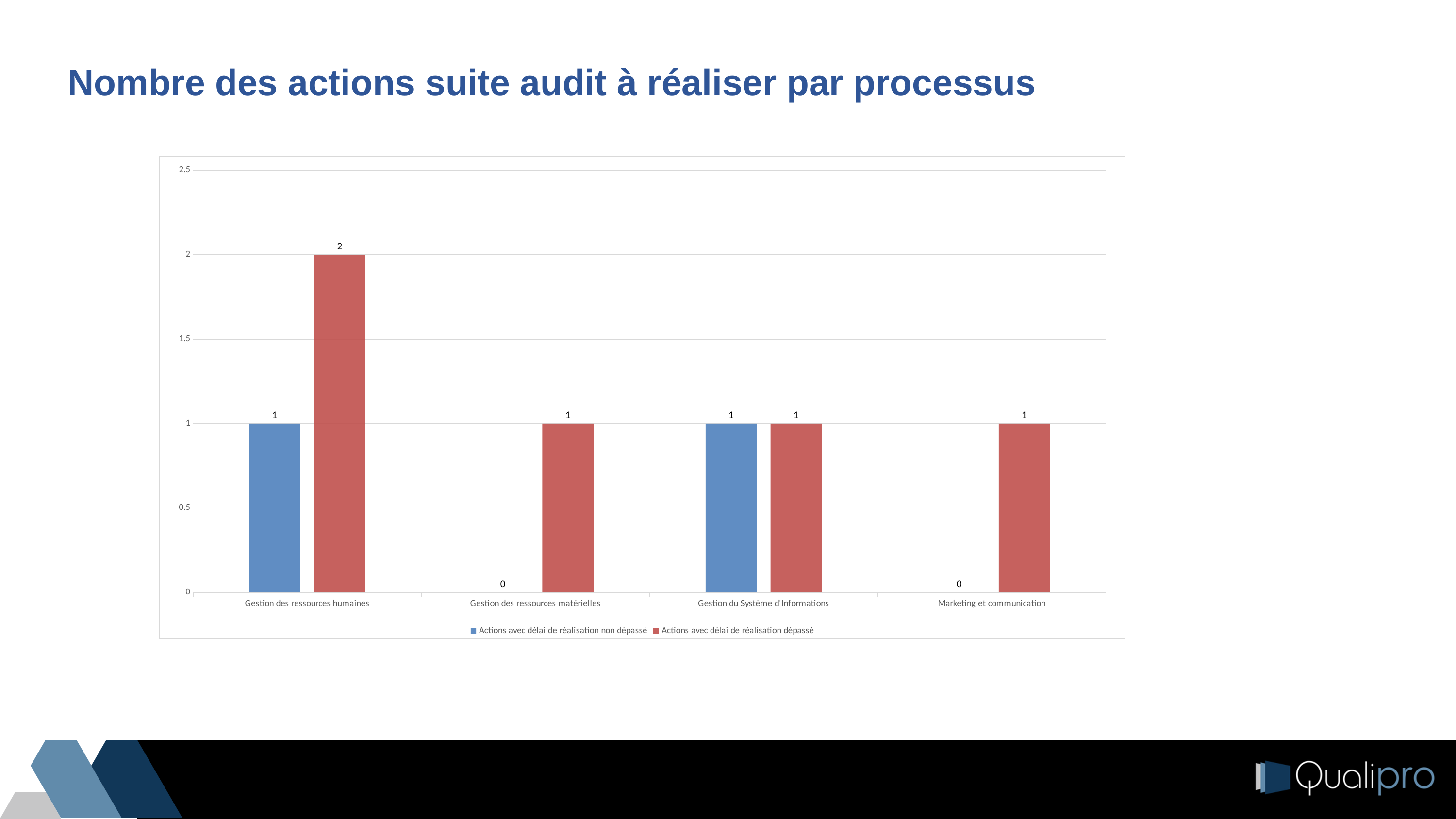
What is the value of 'Actions avec délai de réalisation non dépassé' for Gestion du Système d'Informations? 1 How many processes are shown on the x axis? 4 For Gestion des ressources matérielles, which is larger: 'Actions avec délai de réalisation non dépassé' or 'Actions avec délai de réalisation dépassé'? Actions avec délai de réalisation dépassé Which process has the highest value for 'Actions avec délai de réalisation dépassé'? Gestion des ressources humaines What is the title of the slide? Nombre des actions suite audit à réaliser par processus What is the value of 'Actions avec délai de réalisation dépassé' for Gestion des ressources humaines? 2 Which colour represents 'Actions avec délai de réalisation dépassé' in the legend? Red What is the difference between 'Actions avec délai de réalisation dépassé' and 'Actions avec délai de réalisation non dépassé' for Gestion des ressources humaines? 1 What kind of chart is shown on the slide? Bar chart What is the value of 'Actions avec délai de réalisation non dépassé' for Gestion des ressources matérielles? 0 What is the value of 'Actions avec délai de réalisation dépassé' for Marketing et communication? 1 How many series does the legend list? 2